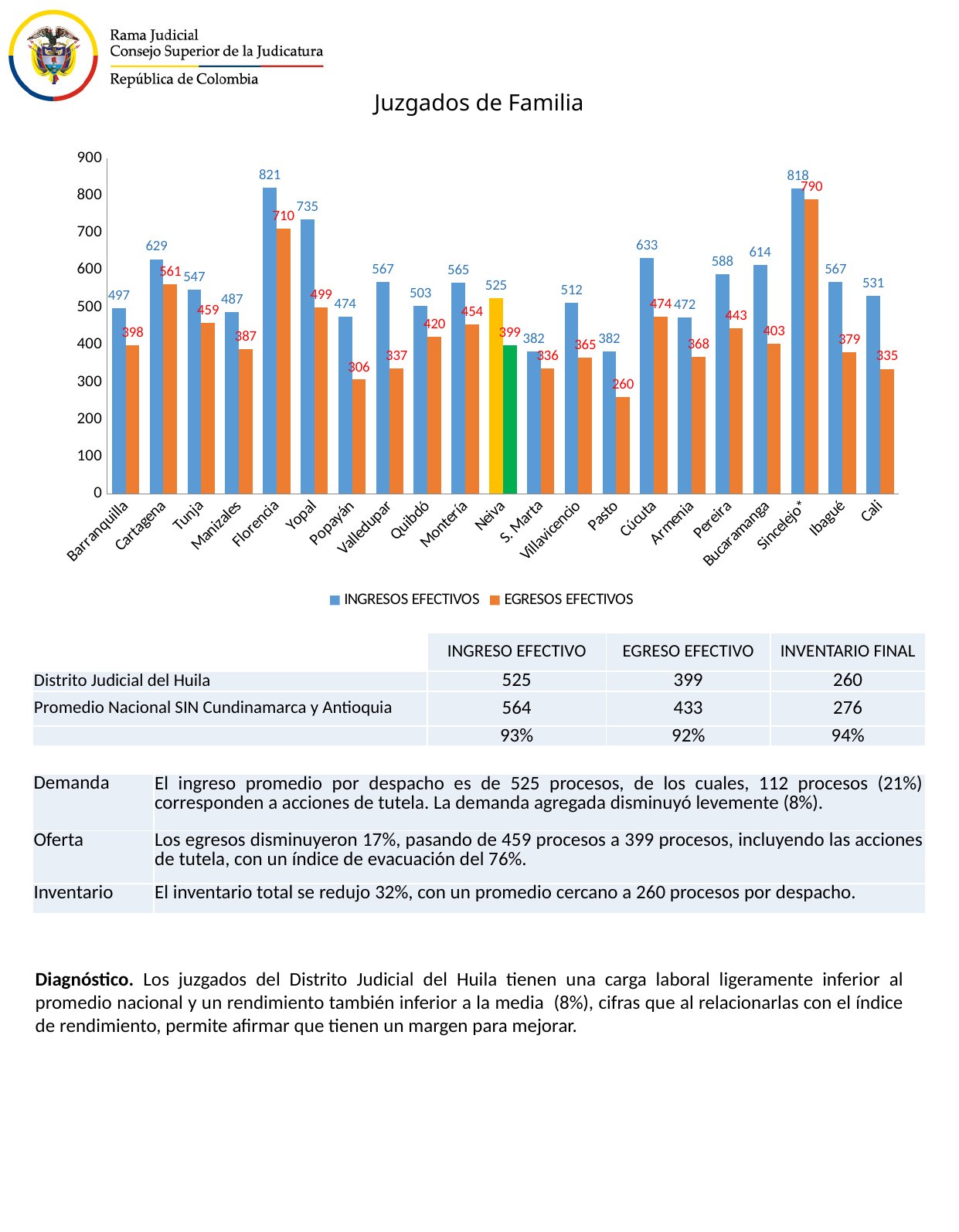
Is the EGRESOS EFECTIVOS value for Pasto greater or less than 300? less Which city has the highest EGRESOS EFECTIVOS value? Sincelejo* Which is larger, the INGRESOS EFECTIVOS value for Cúcuta or for Bucaramanga? Cúcuta Which city has the lowest EGRESOS EFECTIVOS value? Pasto How many series does the chart legend list? 2 What kind of chart is shown on the slide? Bar chart What is the difference between INGRESOS EFECTIVOS and EGRESOS EFECTIVOS for Neiva? 126 Which city has the highest INGRESOS EFECTIVOS value? Florencia What is the EGRESOS EFECTIVOS value for Florencia? 710 What is the EGRESOS EFECTIVOS value for Pasto? 260 What is the INGRESOS EFECTIVOS value for Neiva? 525 How many cities are shown on the x axis of the chart? 21